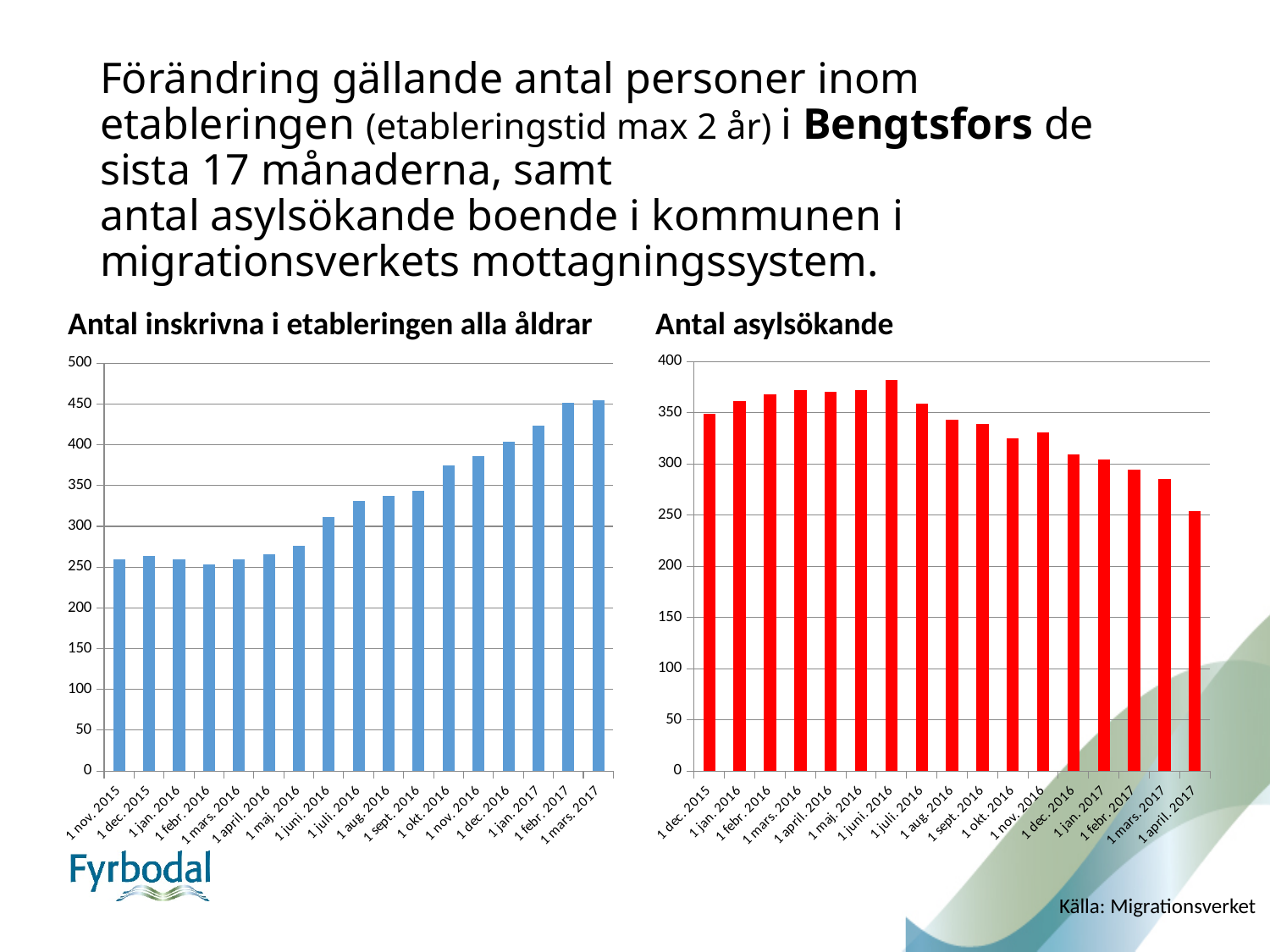
In the 'Antal inskrivna i etableringen alla åldrar' chart, is the value for 1 mars 2017 greater or less than 400? greater What colour are the bars in the 'Antal asylsökande' chart? Red How many bars (months) are shown in the 'Antal inskrivna i etableringen alla åldrar' chart? 17 How many bars (months) are shown in the 'Antal asylsökande' chart? 17 In the 'Antal asylsökande' chart, which month has the highest value? 1 juni 2016 In the 'Antal inskrivna i etableringen alla åldrar' chart, which is larger, the value for 1 juli 2016 or the value for 1 jan. 2017? 1 jan. 2017 In the 'Antal asylsökande' chart, is the value for 1 april 2017 greater or less than 300? less In the 'Antal inskrivna i etableringen alla åldrar' chart, do the values generally rise or fall from 1 nov. 2015 to 1 mars 2017? Rise What kind of chart is the 'Antal inskrivna i etableringen alla åldrar' chart? Bar chart In the 'Antal asylsökande' chart, which month has the lowest value? 1 april 2017 In the 'Antal asylsökande' chart, do the values generally rise or fall from 1 juni 2016 to 1 april 2017? Fall In the 'Antal inskrivna i etableringen alla åldrar' chart, is the value for 1 okt. 2016 greater or less than 350? greater